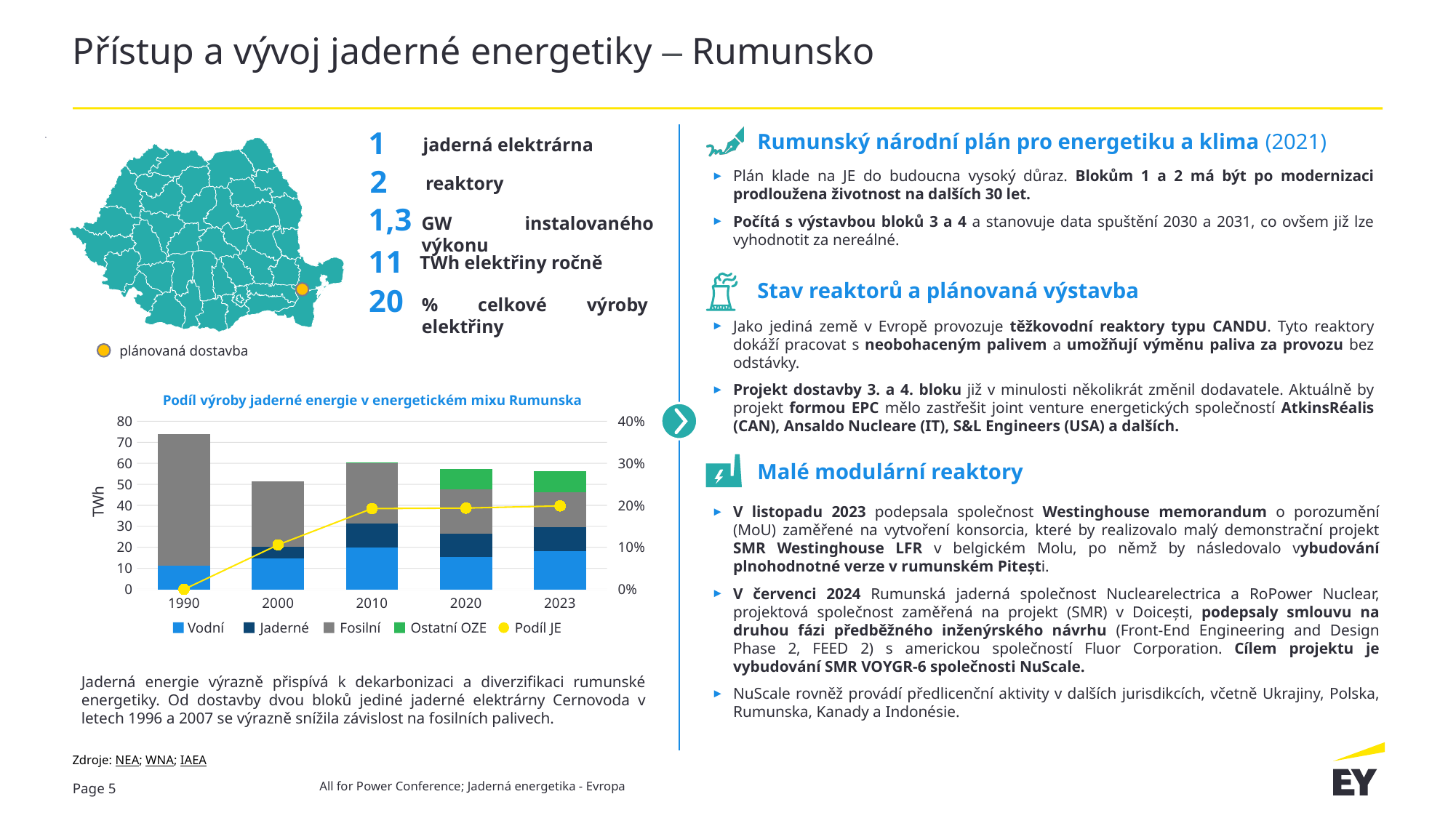
Is the total of the stacked bar for 2000 greater or less than 60 TWh? less Which year has the shortest stacked bar in the chart? 2000 Is the Podíl JE value for 1990 greater or less than 10%? less How many series does the chart legend list? 5 Which year has the larger Fosilní segment, 1990 or 2023? 1990 Is the Podíl JE value for 2010 greater or less than 10%? greater Which year has the tallest stacked bar in the chart? 1990 How many years are shown on the x axis of the chart? 5 Does the Podíl JE line rise or fall from 1990 to 2023? rises What kind of chart is "Podíl výroby jaderné energie v energetickém mixu Rumunska"? A stacked bar chart with a line What is the label of the left vertical axis of the chart? TWh